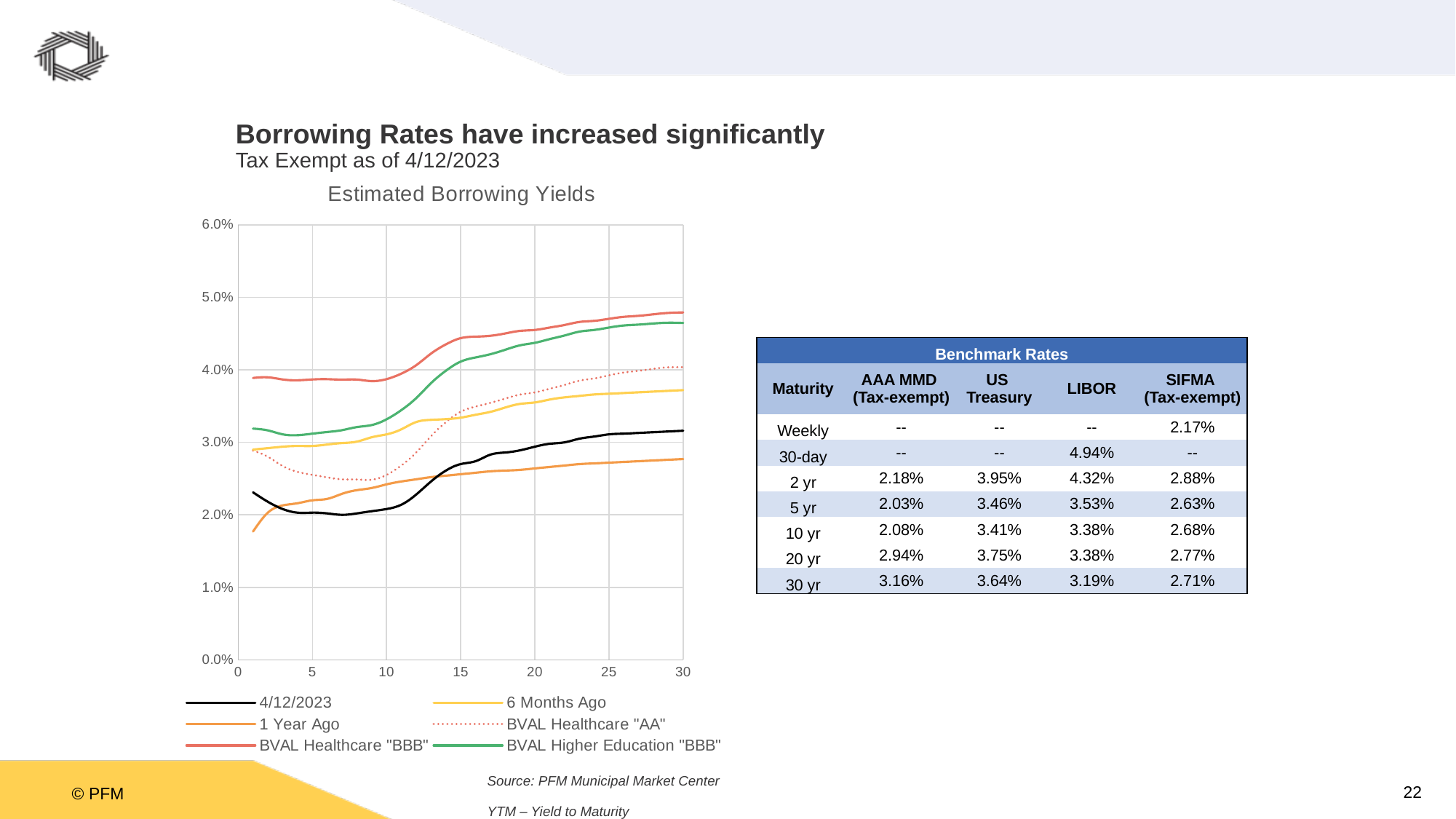
In the Estimated Borrowing Yields chart, is the 4/12/2023 yield at 1 year greater or less than 2.0%? greater Which series in the Estimated Borrowing Yields chart is drawn as a dotted line? BVAL Healthcare "AA" In the Estimated Borrowing Yields chart, does the BVAL Healthcare "BBB" series generally rise or fall as maturity increases from 10 to 30 years? rise In the Estimated Borrowing Yields chart, which series has the highest yield at 30 years? BVAL Healthcare "BBB" What kind of chart is the Estimated Borrowing Yields chart? line chart In the Estimated Borrowing Yields chart, at 1 year, which is higher: the 4/12/2023 series or the 1 Year Ago series? 4/12/2023 In the Estimated Borrowing Yields chart, is the BVAL Healthcare "BBB" yield at 30 years greater or less than 5.0%? less In the Estimated Borrowing Yields chart, is the 1 Year Ago yield at 1 year greater or less than 2.0%? less What is the title of the chart on the slide? Estimated Borrowing Yields In the Estimated Borrowing Yields chart, at 30 years, which is higher: the 6 Months Ago series or the 4/12/2023 series? 6 Months Ago How many series does the legend of the Estimated Borrowing Yields chart list? 6 In the Estimated Borrowing Yields chart, which series has the lowest yield at 30 years? 1 Year Ago